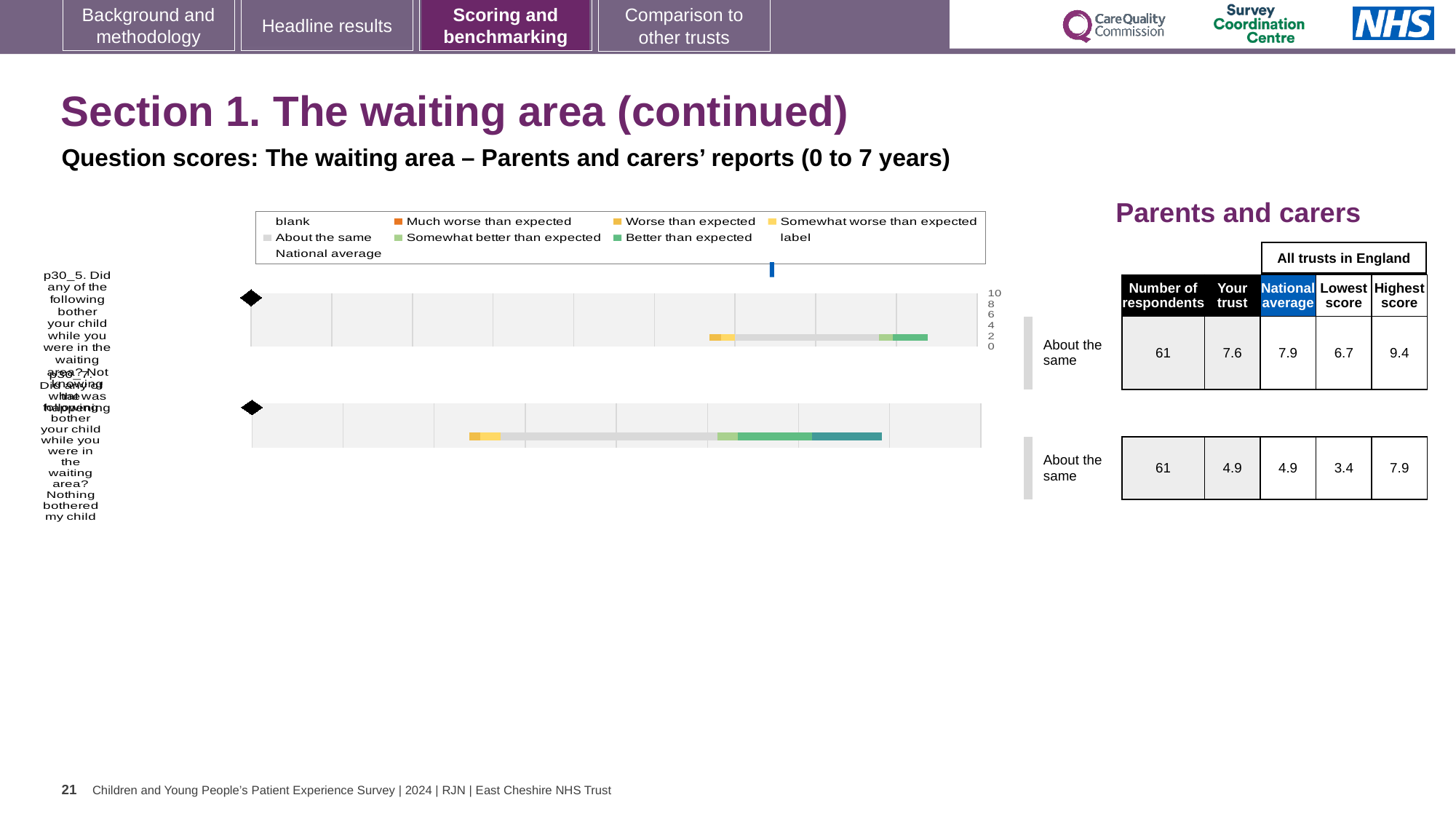
What is the lowest tick value shown on the chart's axis? 0 What colour does the legend use for 'About the same'? grey How many question bars are plotted in the chart? 2 What is the highest tick value shown on the chart's axis? 10 What kind of chart is shown on the slide? bar chart Which legend entry is shown in orange? Much worse than expected